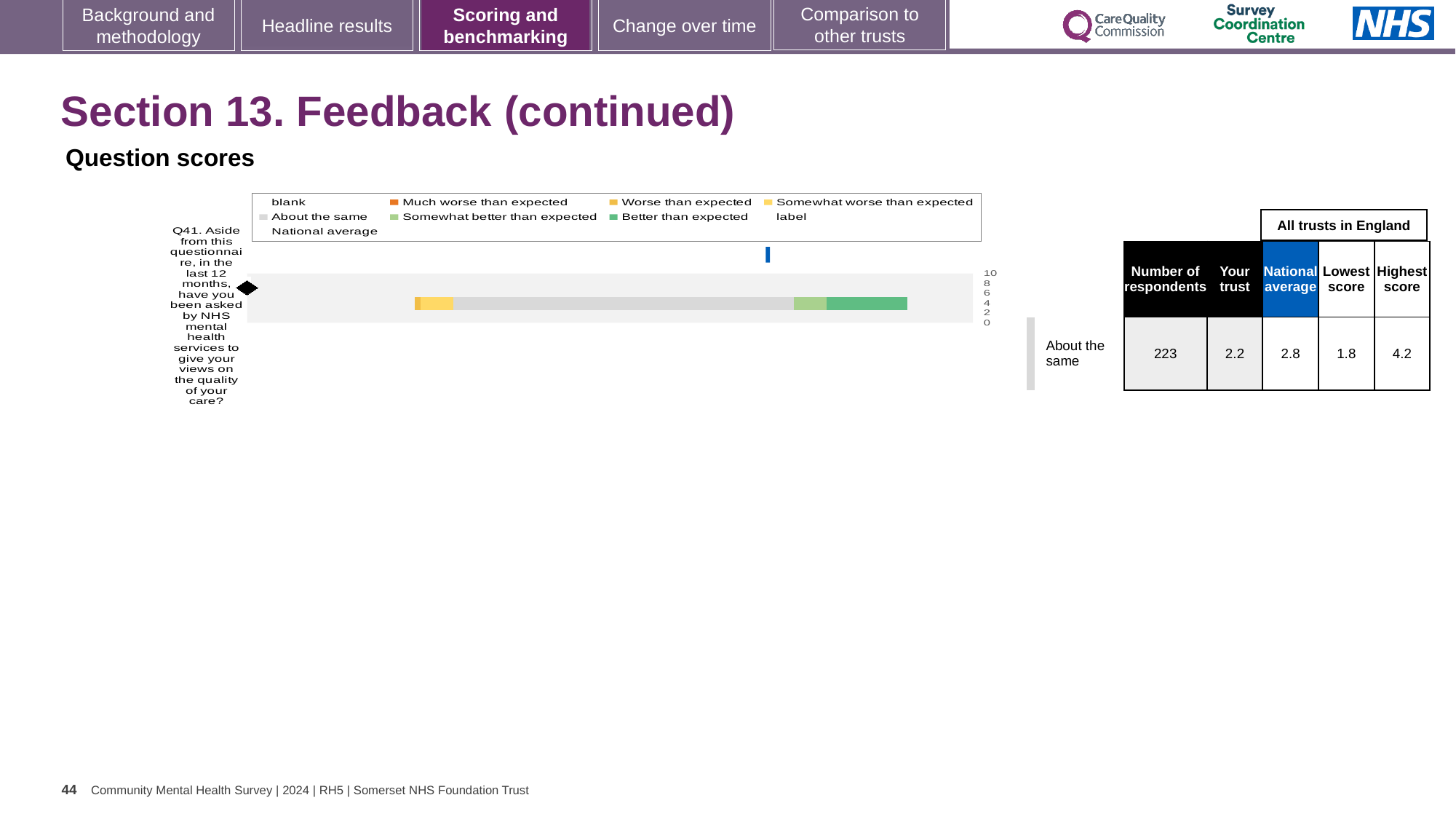
Which question number is plotted in the chart on the slide? Q41 What colour does the chart legend use for 'Better than expected'? green What benchmark category is the trust's Q41 result assigned to on the slide? About the same According to the table next to the chart, what is the 'Your trust' score for Q41? 2.2 For Q41, what is the difference between the highest score and the lowest score among all trusts in England? 2.4 What kind of chart is shown for Q41 on the slide? bar chart For Q41, which is larger: the 'Your trust' score or the national average? National average According to the table next to the chart, how many respondents answered Q41? 223 According to the table next to the chart, what is the highest score among all trusts in England for Q41? 4.2 According to the table next to the chart, what is the national average score for Q41? 2.8 How many survey questions are plotted in the chart on the slide? 1 According to the table next to the chart, what is the lowest score among all trusts in England for Q41? 1.8